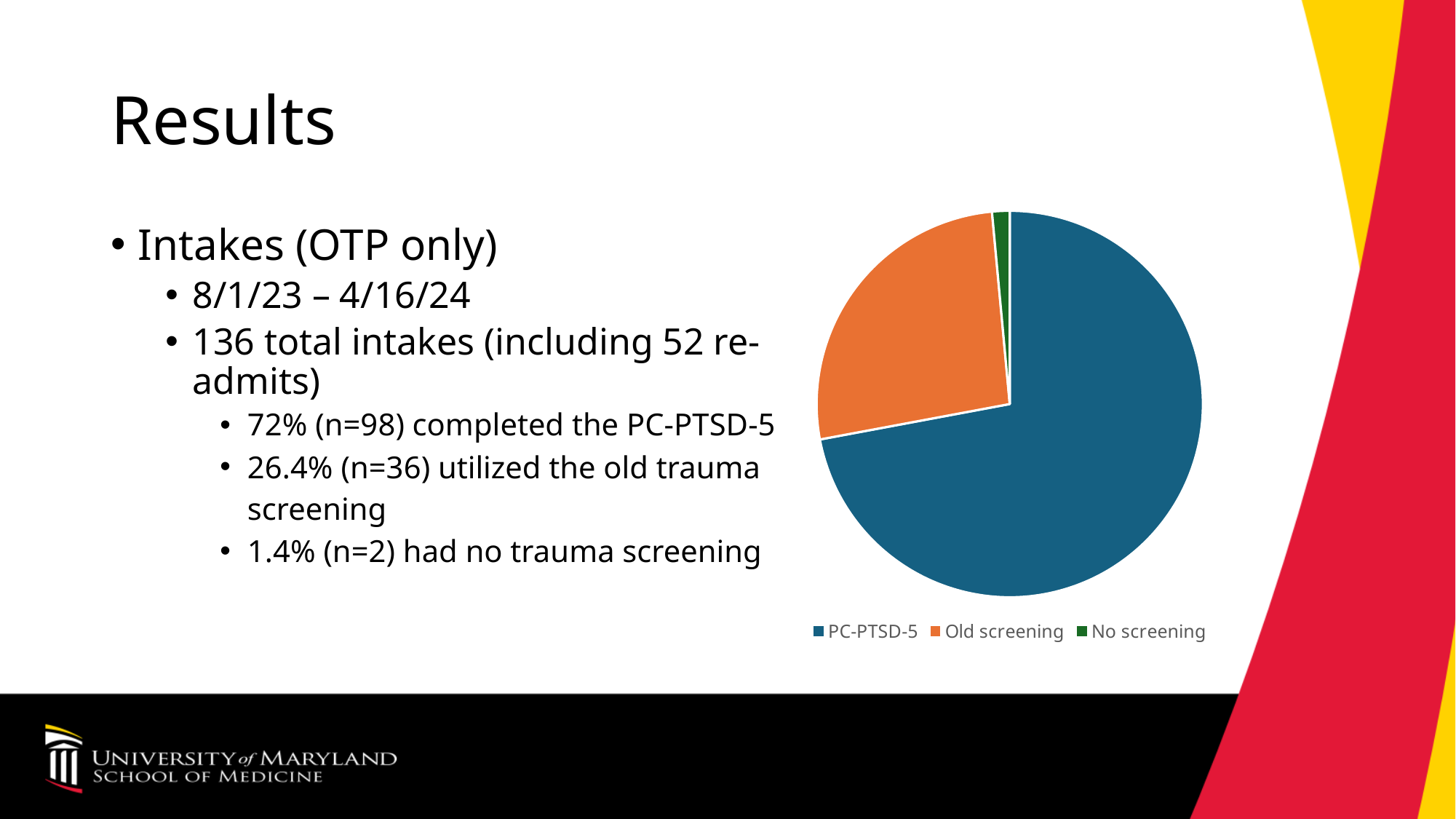
According to the slide, what share of intakes does the Old screening slice represent? 26.4% What are the three legend entries of the pie chart? PC-PTSD-5, Old screening, No screening Which slice is larger in the pie chart, Old screening or No screening? Old screening How many slices does the pie chart have? 3 What colour is the PC-PTSD-5 slice in the pie chart? blue Which slice is larger in the pie chart, PC-PTSD-5 or Old screening? PC-PTSD-5 According to the slide, what share of intakes does the No screening slice represent? 1.4% According to the slide, what share of intakes does the PC-PTSD-5 slice represent? 72% Which category has the smallest slice of the pie chart? No screening How many entries does the pie chart's legend list? 3 Which category has the largest slice of the pie chart? PC-PTSD-5 What kind of chart is shown on the slide? pie chart